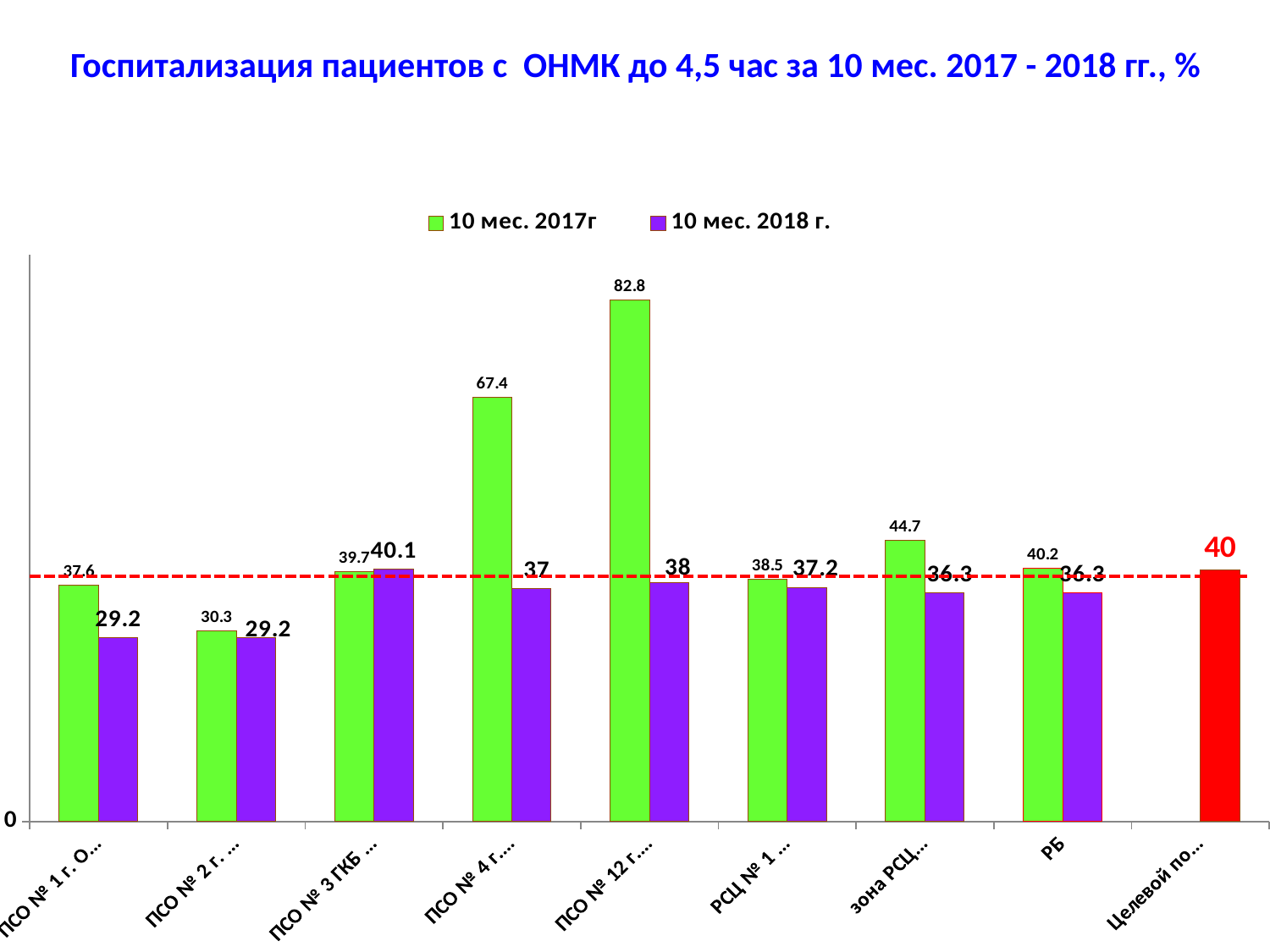
What is the value for РБ in the 10 мес. 2018 г. series? 36.3 How many categories are shown on the x axis? 9 How many series does the legend list? 2 Which category has the highest value in the 10 мес. 2017г series? ПСО № 12 г.... Which category has the lowest value in the 10 мес. 2017г series? ПСО № 2 г. ... What is the difference between the 2017 and 2018 values for ПСО № 4 г....? 30.4 What is the value of the red bar for the Целевой по... category? 40 For ПСО № 3 ГКБ ..., which series has the larger value, 10 мес. 2017г or 10 мес. 2018 г.? 10 мес. 2018 г. What kind of chart is shown on the slide? Bar chart What is the difference between the 2017 and 2018 values for ПСО № 12 г....? 44.8 What is the value for РБ in the 10 мес. 2017г series? 40.2 What is the 10 мес. 2017г value for зона РСЦ...? 44.7